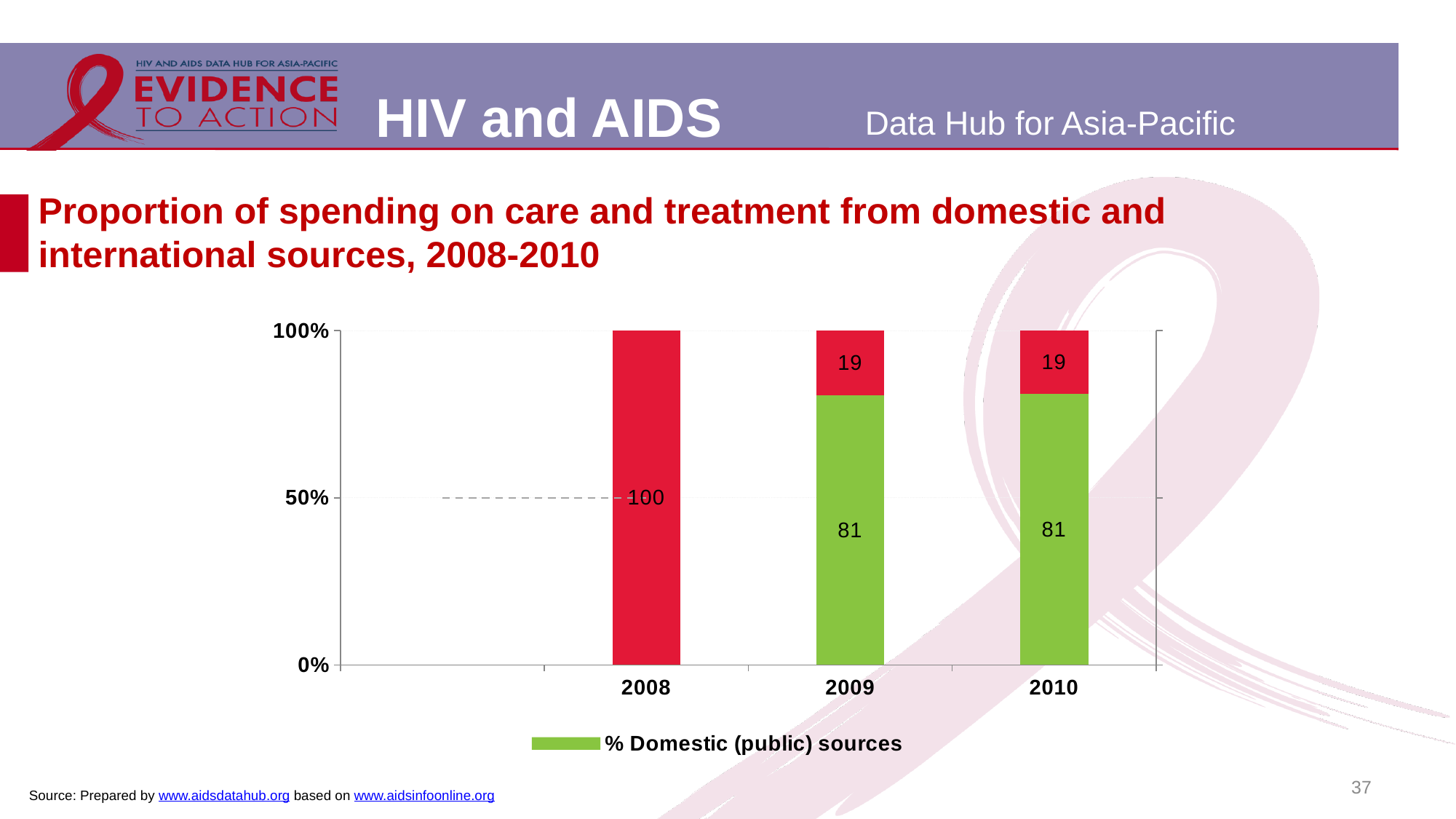
What is the difference between the domestic (public) sources value and the red segment value in 2010? 62 What value is printed on the red segment of the 2009 bar? 19 Is the value for % Domestic (public) sources in 2009 greater or less than 50%? greater What type of chart is shown on the slide? stacked bar chart What is the value for % Domestic (public) sources in 2010? 81 What value is printed on the red segment of the 2008 bar? 100 What is the total of the stacked bar for 2010? 100 What is the value for % Domestic (public) sources in 2009? 81 How many years are shown on the x axis of the chart? 3 How many series does the chart's legend list? 1 In 2009, which is larger: the green domestic (public) sources segment or the red segment? the green domestic (public) sources segment What series name is shown in the chart's legend? % Domestic (public) sources